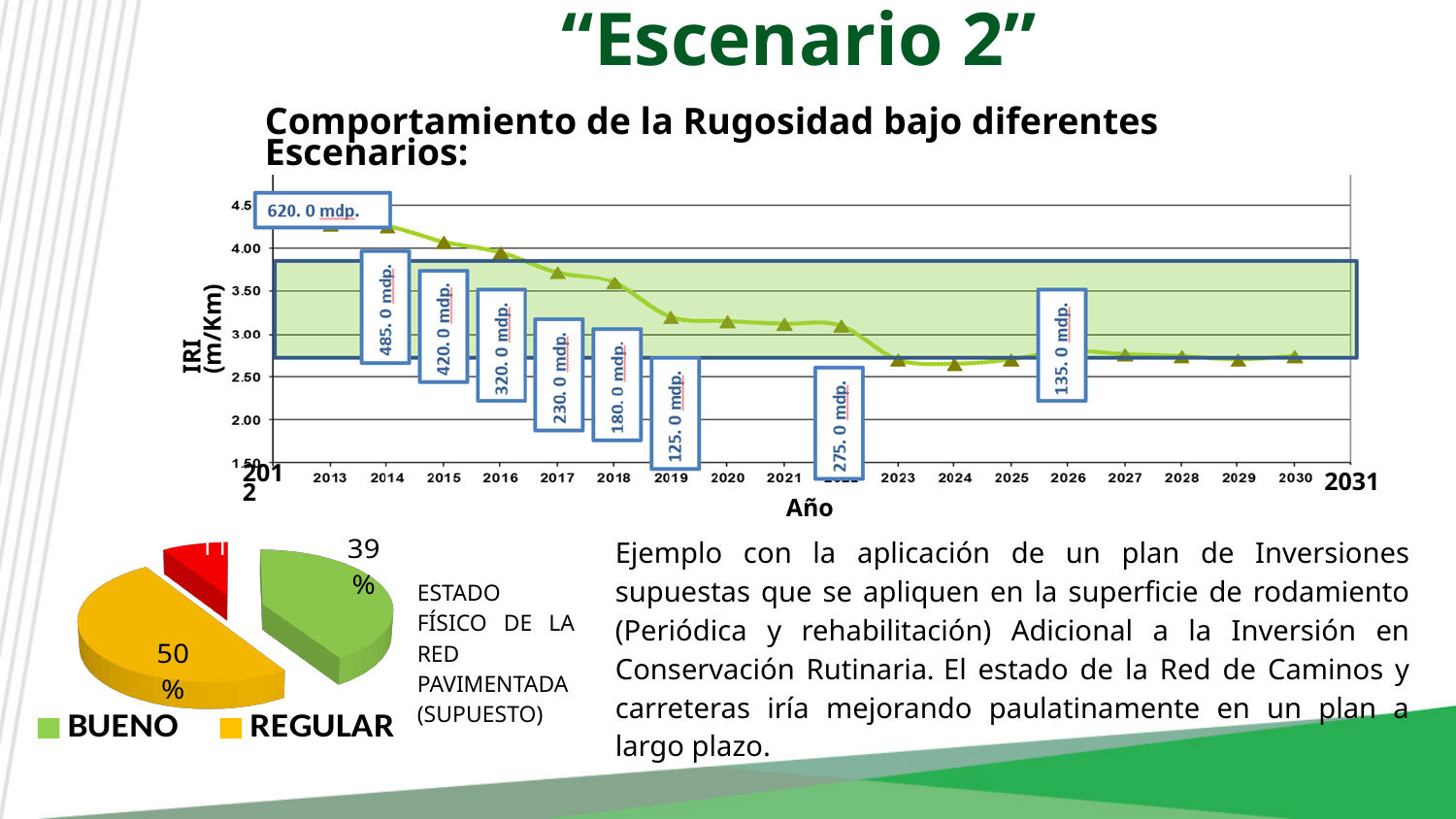
In the upper IRI chart, what is the label of the y axis? IRI (m/Km) In the upper IRI chart, what investment amount is labelled in the box above the 2013–2014 points? 620. 0 mdp. In the upper IRI chart, is the IRI value for 2013 greater or less than 4.00? greater What type of chart is the lower-left chart about the Estado físico de la red pavimentada? pie chart In the upper IRI chart, is the IRI value for 2019 greater or less than 3.00? greater In the lower-left pie chart, what share does the BUENO slice have? 39% In the upper IRI chart, what investment amount is labelled in the box at 2019? 125. 0 mdp. In the upper IRI chart, do the IRI values rise or fall from 2013 to 2030? fall In the lower-left pie chart, which slice is larger, BUENO or REGULAR? REGULAR In the upper IRI chart, what investment amount is labelled in the box at 2026? 135. 0 mdp. What type of chart is the upper chart showing IRI (m/Km) by Año? line chart In the upper IRI chart, is the IRI value for 2024 greater or less than 3.00? less